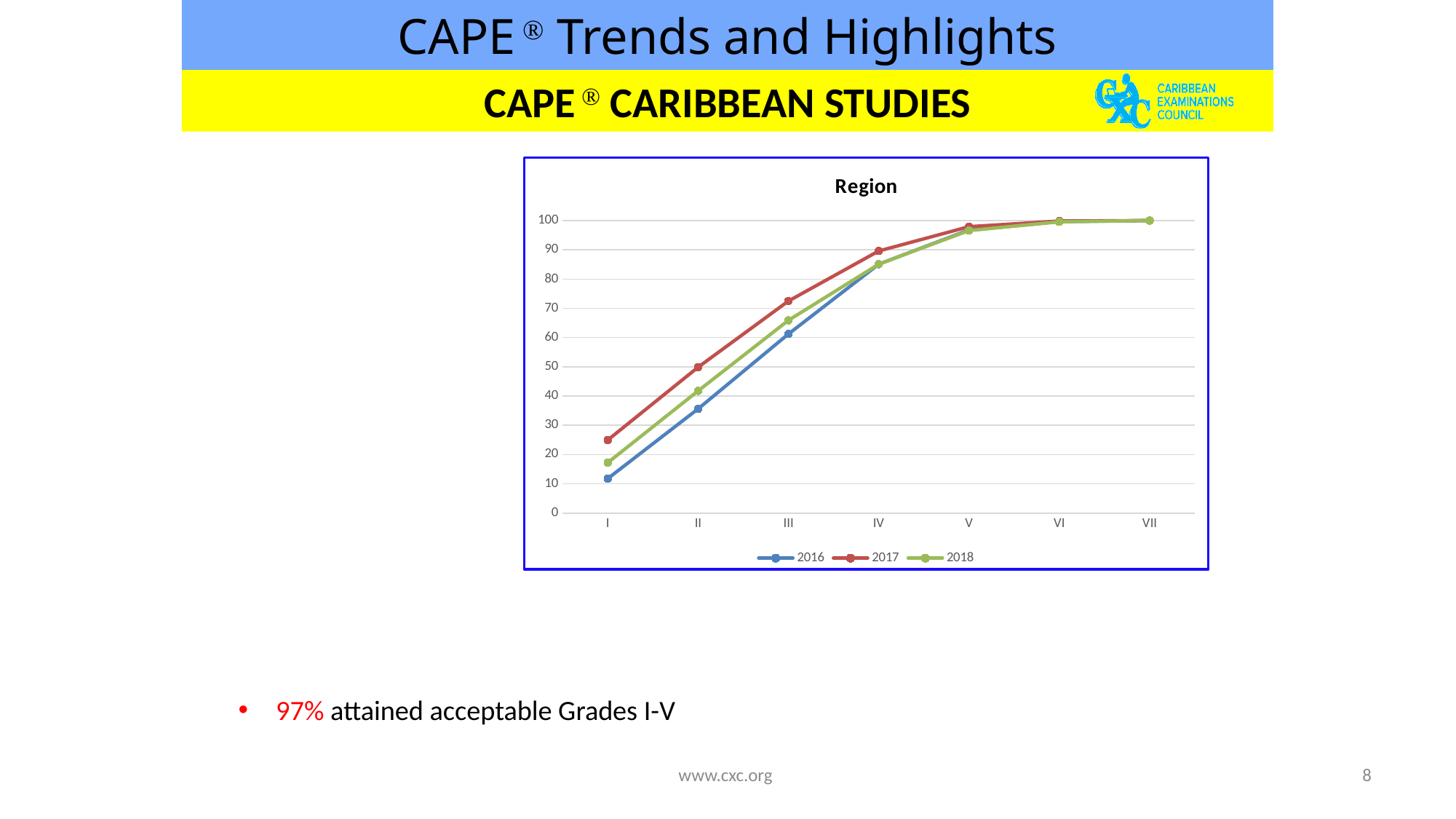
At grade I, which series has the larger value, 2016 or 2017? 2017 Do the values for 2017 rise or fall from grade I to grade VII? rise Which years are listed in the legend? 2016, 2017, 2018 Is the value for 2017 at grade II greater or less than 40? greater What kind of chart is shown on the slide? line chart What is the title of the chart? Region How many series does the legend list? 3 For the 2017 series, at which grade is the value lowest? I How many categories are shown on the x axis? 7 At grade III, which series has the larger value, 2016 or 2018? 2018 Is the value for 2016 at grade I greater or less than 20? less Is the value for 2018 at grade III greater or less than 60? greater